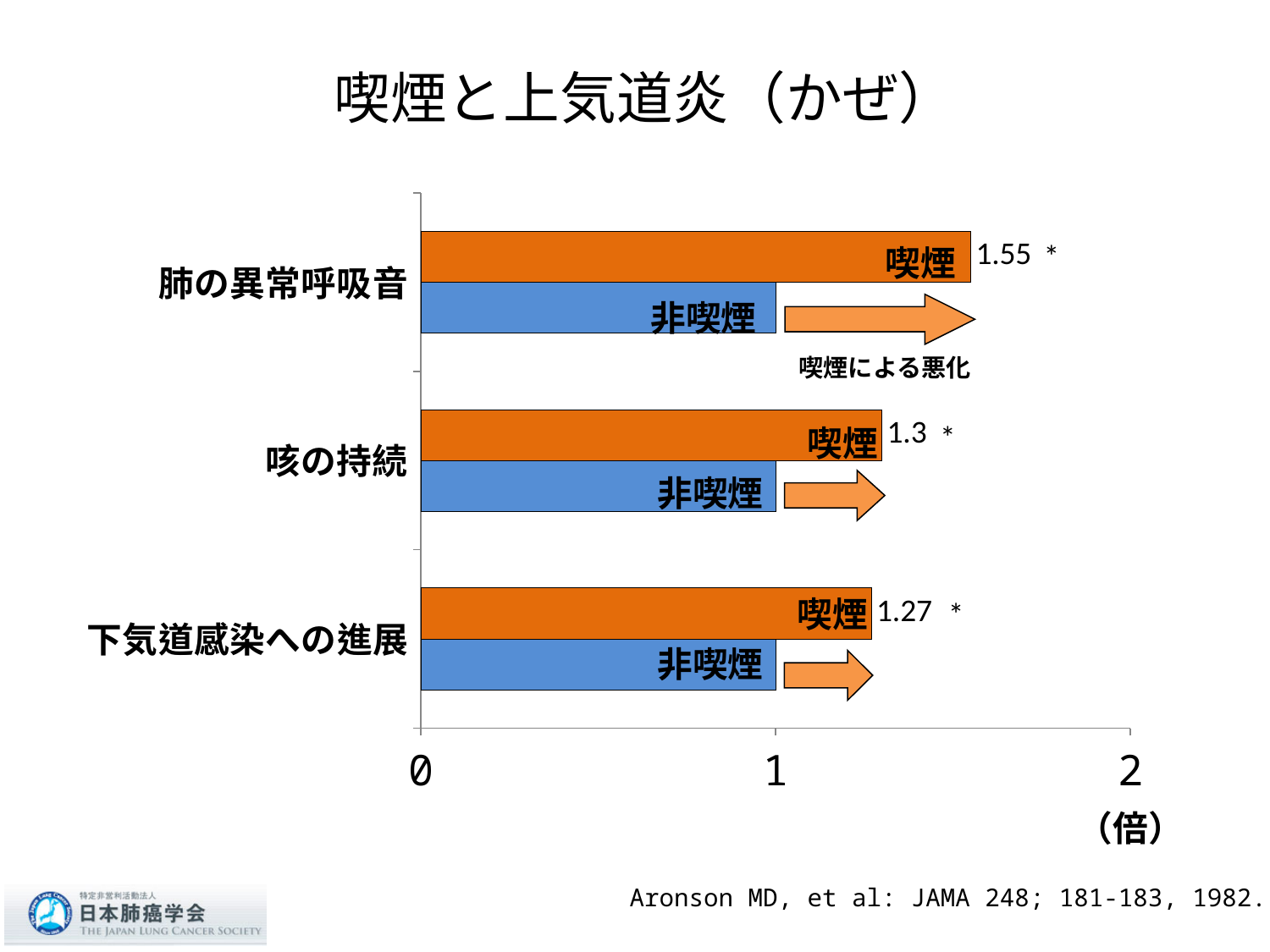
Which category has the highest 喫煙 value? 肺の異常呼吸音 What is the difference between the 喫煙 values for 肺の異常呼吸音 and 咳の持続? 0.25 What is the value for 喫煙 in the 咳の持続 category? 1.3 What is the value for 喫煙 in the 下気道感染への進展 category? 1.27 What is the value for 喫煙 in the 肺の異常呼吸音 category? 1.55 What value does the 非喫煙 bar reach in the 咳の持続 category? 1 How many categories are shown on the chart? 3 Which is larger, the 喫煙 value for 肺の異常呼吸音 or the 喫煙 value for 下気道感染への進展? 肺の異常呼吸音 What is the title of the slide? 喫煙と上気道炎（かぜ） Is the 喫煙 value for 肺の異常呼吸音 greater or less than 2? less Which category has the lowest 喫煙 value? 下気道感染への進展 What kind of chart is shown on the slide? bar chart